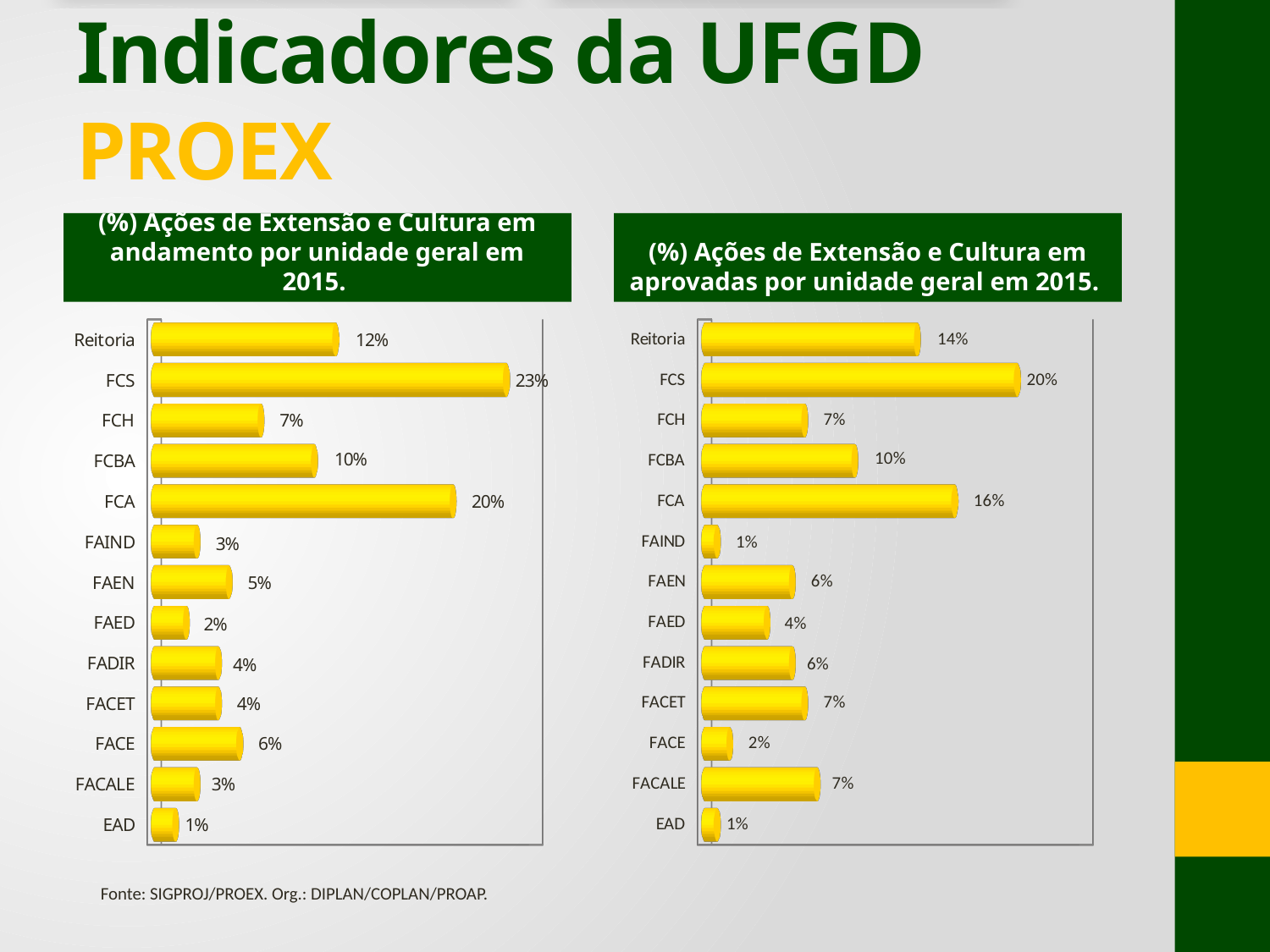
What kind of chart is the right chart (ações aprovadas)? Bar chart In the left chart (ações em andamento), which unit has the lowest value? EAD In the right chart (ações aprovadas), which unit has the highest value? FCS In the left chart (ações em andamento), which is larger, FACE or FAEN? FACE How many units are shown in the left chart (ações em andamento)? 13 In the left chart (ações em andamento), what is the difference between FCS and Reitoria? 11% In the right chart (ações aprovadas), what is the value for Reitoria? 14% In the left chart (ações em andamento), what is the value for FCA? 20% In the left chart (ações em andamento), which unit has the highest value? FCS In the right chart (ações aprovadas), what is the difference between FCA and FCBA? 6% In the right chart (ações aprovadas), which is larger, FAEN or FACET? FACET In the right chart (ações aprovadas), what is the value for FAIND? 1%